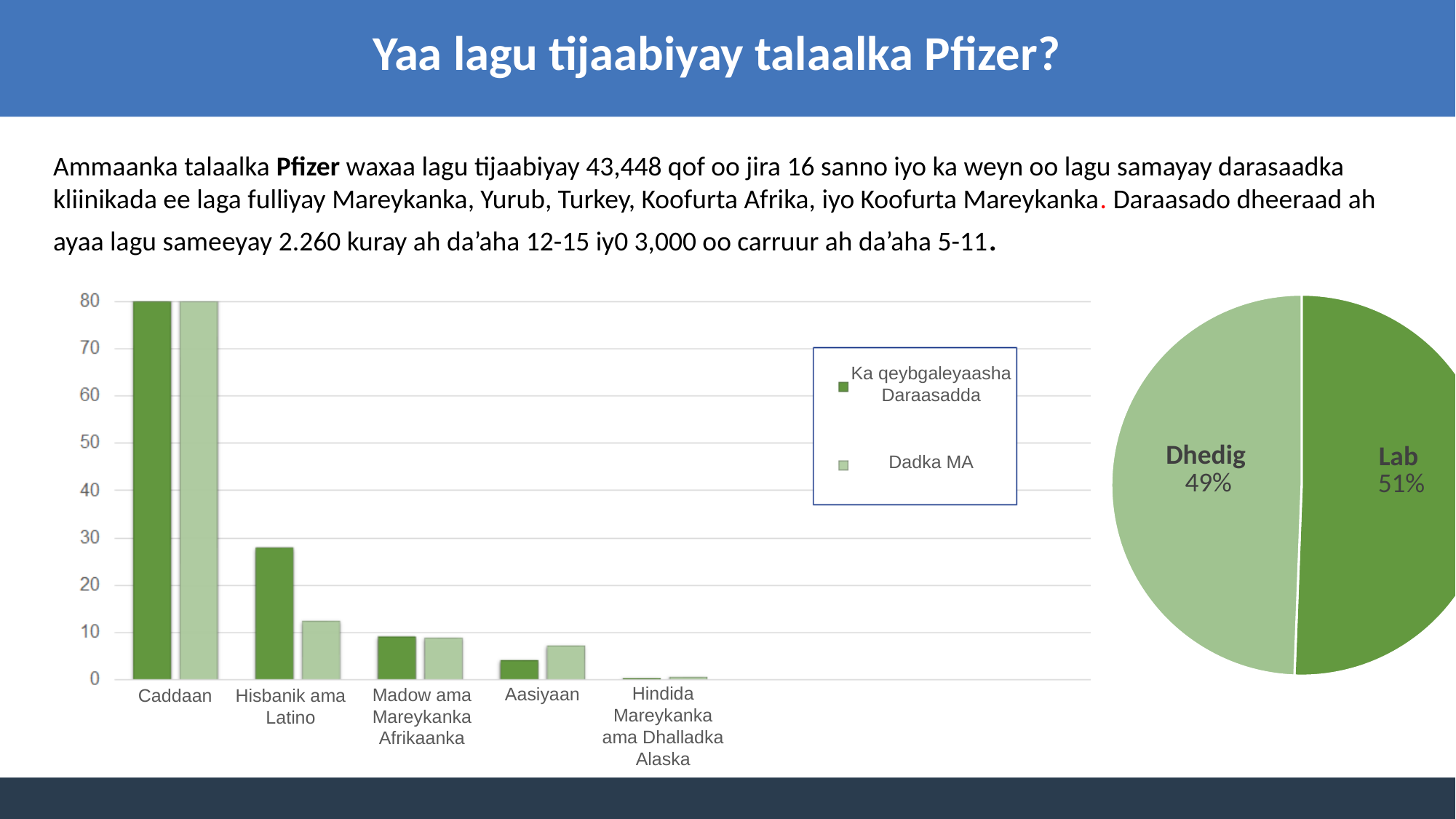
What kind of chart is the chart on the left of the slide? bar chart In the bar chart on the left, what is the value of Ka qeybgaleyaasha Daraasadda for Caddaan? 80 In the pie chart on the right, what share does Lab have? 51% In the bar chart on the left, how many categories are shown on the x axis? 5 In the bar chart on the left, how many series does the legend list? 2 In the pie chart on the right, what share does Dhedig have? 49% What kind of chart is the chart on the right of the slide? pie chart In the bar chart on the left, what are the two legend entries? Ka qeybgaleyaasha Daraasadda and Dadka MA In the bar chart on the left, is the Dadka MA value for Hisbanik ama Latino greater or less than 20? less In the bar chart on the left, which category has the highest bars? Caddaan In the bar chart on the left, is the Ka qeybgaleyaasha Daraasadda value for Hisbanik ama Latino greater or less than 20? greater In the bar chart on the left, for Aasiyaan, which series has the larger value: Ka qeybgaleyaasha Daraasadda or Dadka MA? Dadka MA